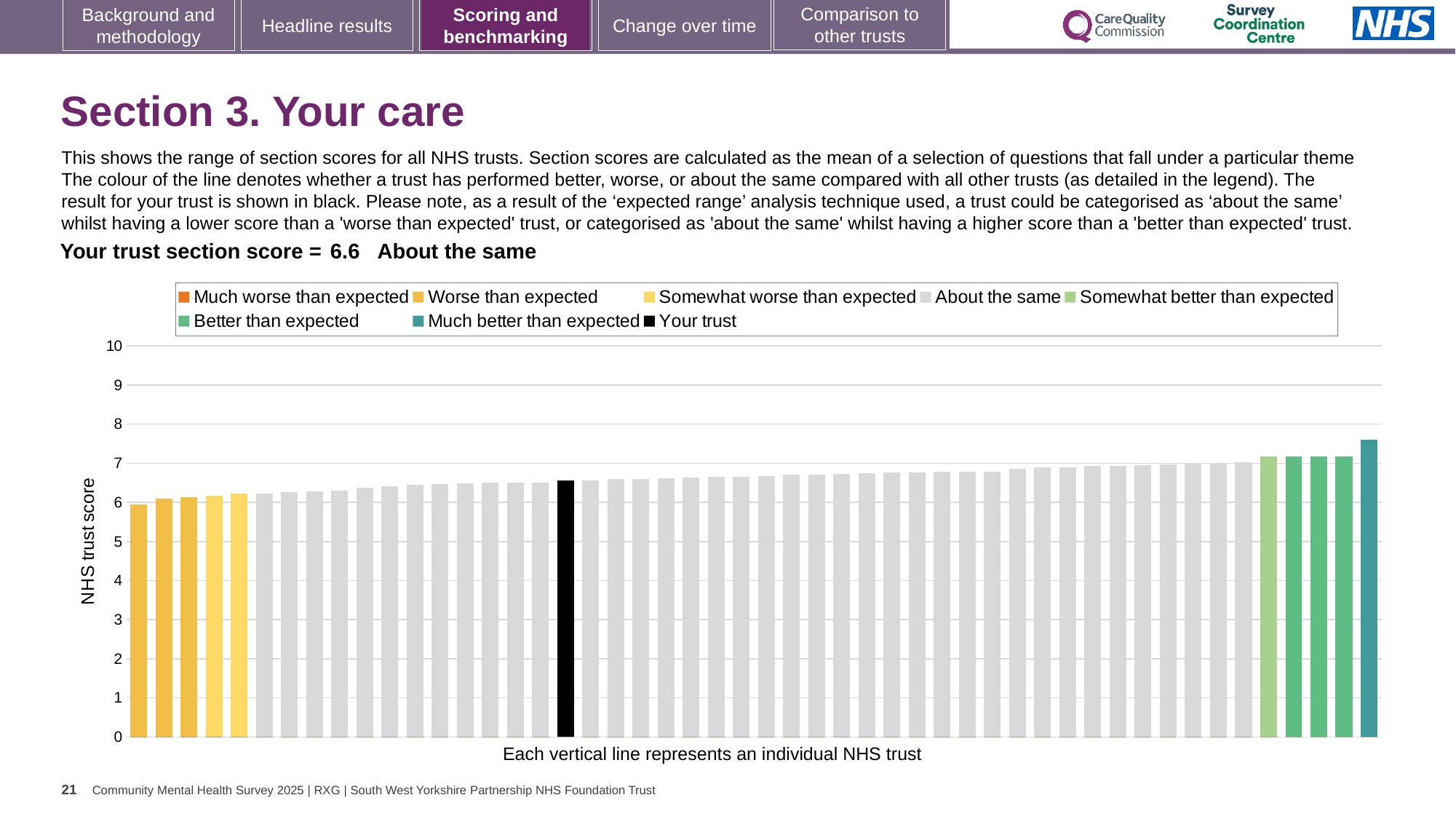
Which is larger: the rightmost bar or the bar for your trust? The rightmost bar Is the value for your trust (the black bar) greater or less than 6? greater What is the label on the vertical axis of the chart? NHS trust score Do the bar values rise or fall from left to right across the chart? Rise How is your trust's section score categorised compared with other trusts? About the same Is the tallest bar in the chart greater or less than 8? less What colour is used for the bar representing your trust? Black What kind of chart is shown on the slide? Bar chart Is the shortest bar in the chart greater or less than 7? less How many entries does the chart legend list? 8 What is the section score for your trust shown on the slide? 6.6